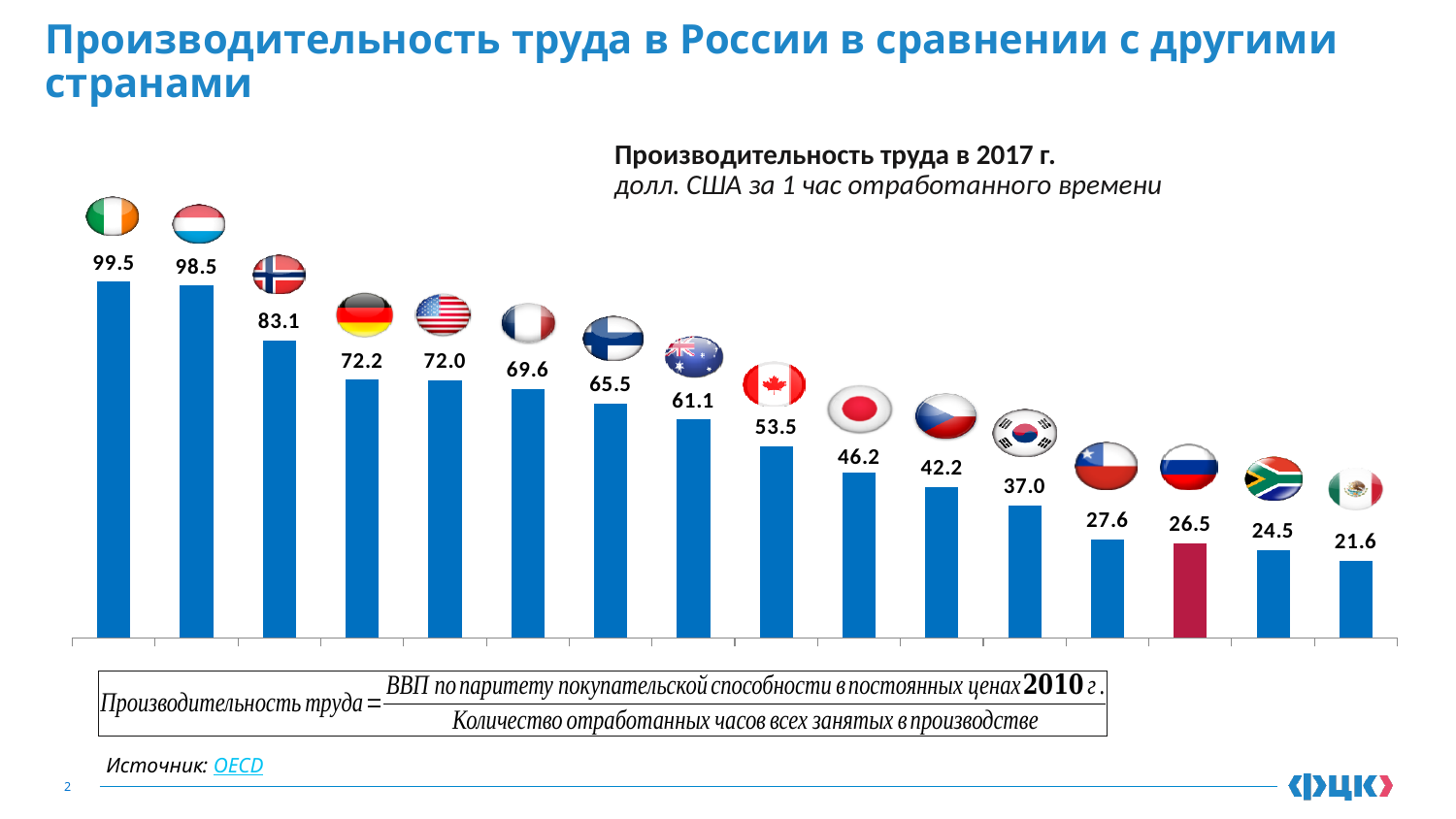
How many bars (countries) are plotted in the chart? 16 What is the difference between the highest bar (99.5) and the red-highlighted Russian bar (26.5)? 73.0 What is the highest value shown in the chart? 99.5 What is the value of the red-highlighted bar (the one with the Russian flag)? 26.5 Which is larger: the bar with the Japanese flag or the bar with the Czech flag? The bar with the Japanese flag (46.2) What is the value of the bar with the US flag? 72.0 Do the bar values rise or fall from left to right across the chart? Fall What is the lowest value shown in the chart (the last bar, with the Mexican flag)? 21.6 By how much does the bar with the Chilean flag (27.6) exceed the red-highlighted Russian bar (26.5)? 1.1 What unit is stated in the chart subtitle? долл. США за 1 час отработанного времени What kind of chart is shown on the slide? Bar chart What is the value of the third bar from the left (with the Norwegian flag)? 83.1